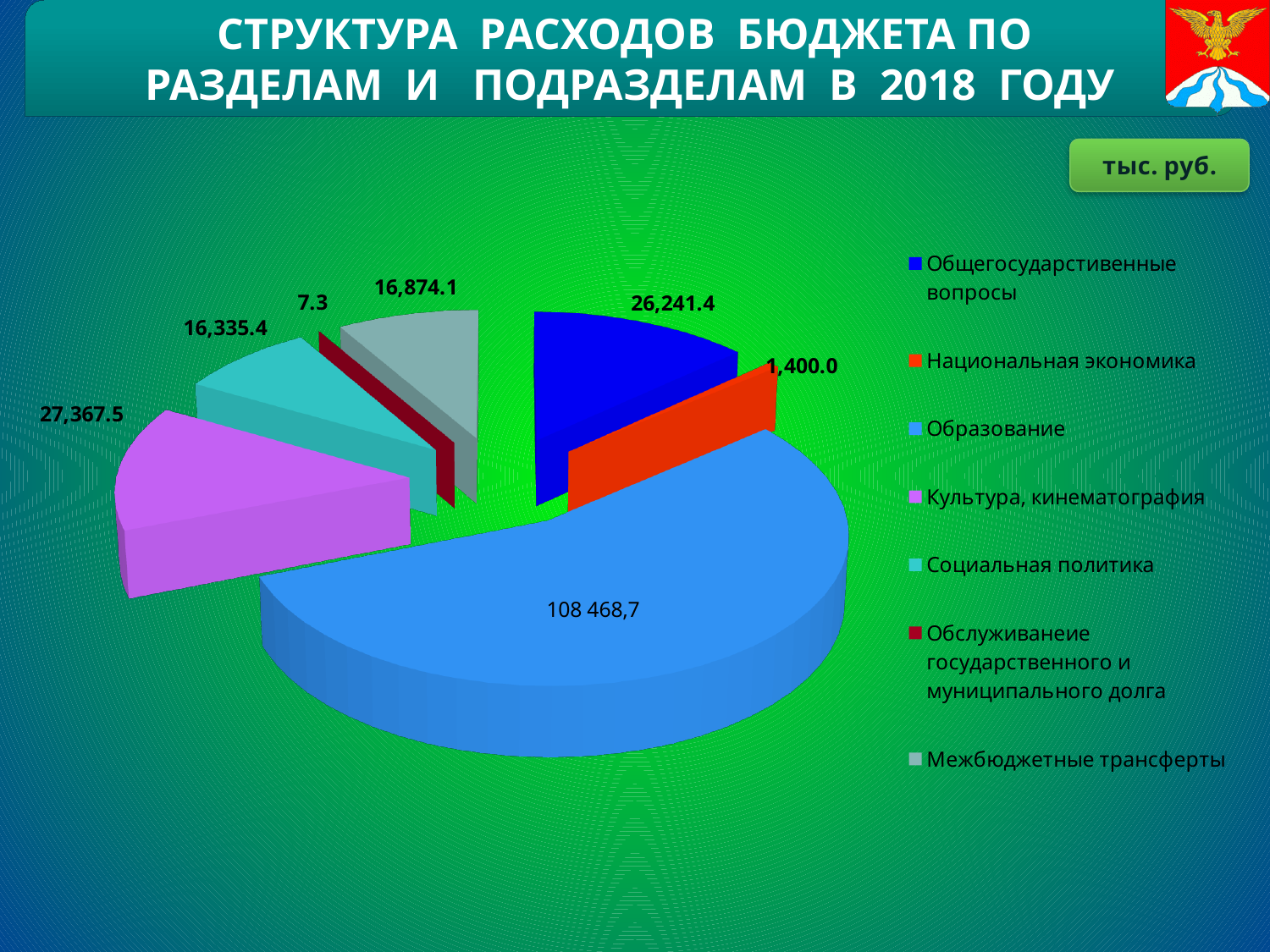
What is the value for Общегосударственные вопросы? 26,241.4 What is the value for Образование? 108 468,7 What is the value for Обслуживание государственного и муниципального долга? 7.3 Which category has the largest slice of the pie? Образование What is the value for Межбюджетные трансферты? 16,874.1 In what units are the values on the chart given? тыс. руб. What is the difference between the values for Культура, кинематография and Общегосударственные вопросы? 1,126.1 How many categories does the legend list? 7 Which category has the smallest slice of the pie? Обслуживание государственного и муниципального долга What is the value for Культура, кинематография? 27,367.5 Which is larger, the value for Межбюджетные трансферты or the value for Социальная политика? Межбюджетные трансферты What type of chart is shown on the slide? pie chart